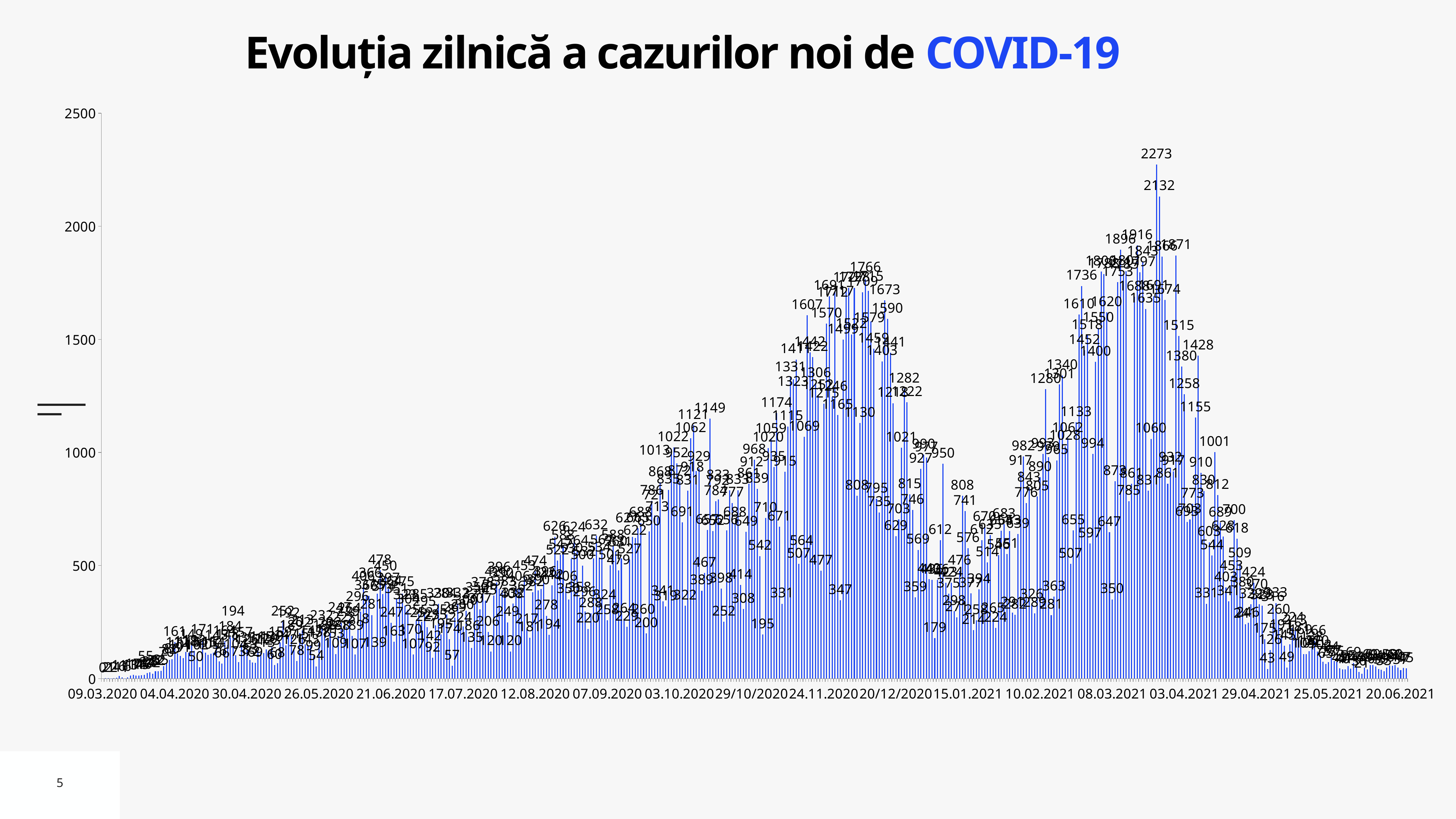
Is the value at the start of the chart (09.03.2020) greater or less than 500? less Is the value at the end of the chart (20.06.2021) greater or less than 500? less Do the values rise or fall between 03.04.2021 and 20.06.2021? fall What is the highest daily value shown in the chart? 2273 What kind of chart is shown on the slide? bar chart What is the second-highest labelled value in the chart, next to the 2273 peak? 2132 What is the highest tick value shown on the vertical axis? 2500 Is the highest peak of the chart located in 2020 or in 2021? 2021 Is the highest value in the chart greater or less than 2000? greater Do the values rise or fall between 09.03.2020 and 04.04.2020? rise What is the difference between the two highest labelled values, 2273 and 2132? 141 What is the title of the chart? Evoluția zilnică a cazurilor noi de COVID-19